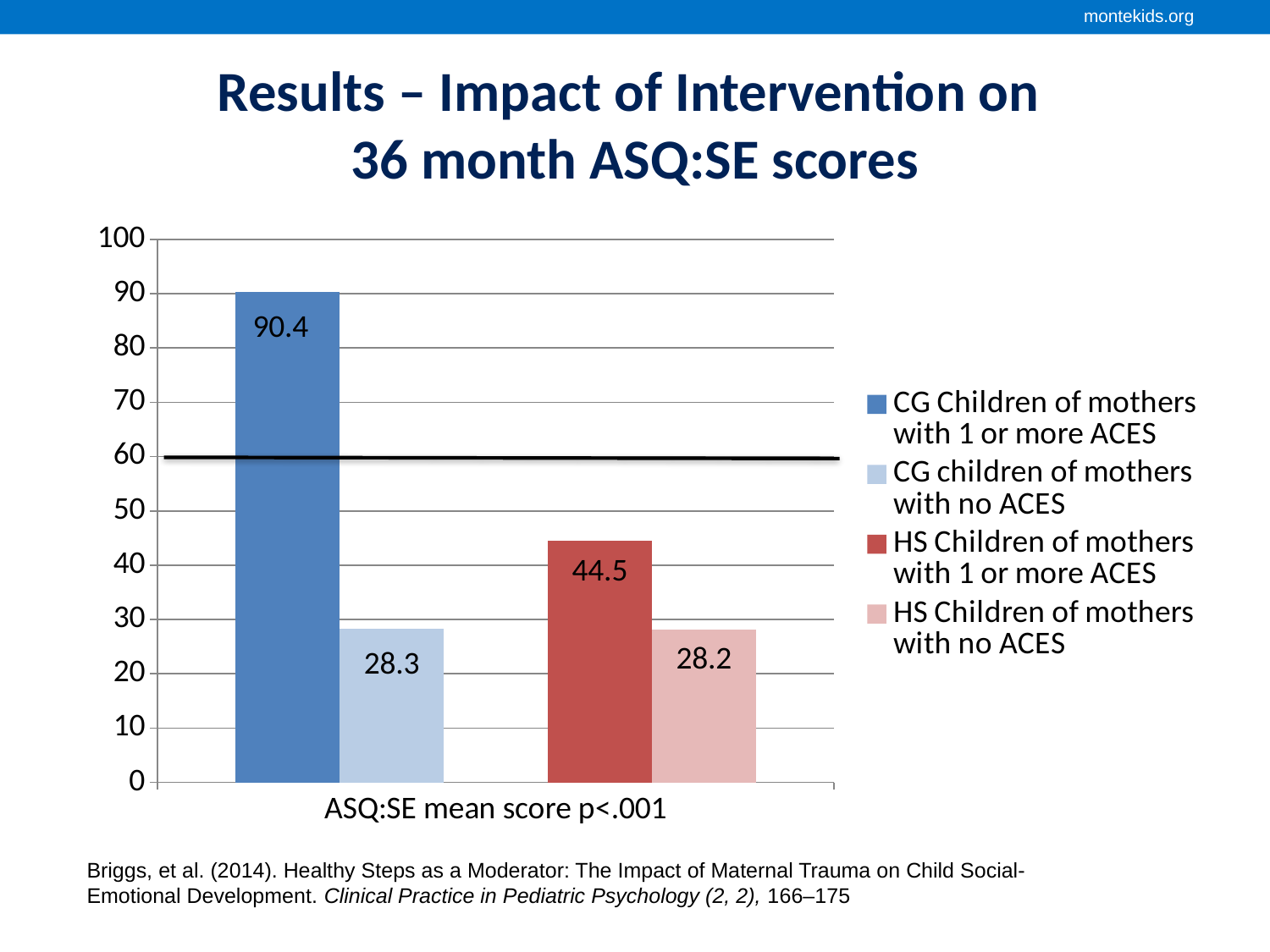
Which series has the highest value? CG Children of mothers with 1 or more ACES Is the value for HS Children of mothers with 1 or more ACES greater or less than 60? less How many series does the legend list? 4 What is the value for CG Children of mothers with 1 or more ACES? 90.4 Which is larger, the value for CG Children of mothers with 1 or more ACES or the value for HS Children of mothers with 1 or more ACES? CG Children of mothers with 1 or more ACES At what value on the y axis is the horizontal black line drawn across the chart? 60 What kind of chart is shown on the slide? bar chart What is the value for HS Children of mothers with 1 or more ACES? 44.5 What is the value for CG children of mothers with no ACES? 28.3 What is the value for HS Children of mothers with no ACES? 28.2 What is the difference between the values for CG Children of mothers with 1 or more ACES and HS Children of mothers with 1 or more ACES? 45.9 What is the x-axis category label under the bars? ASQ:SE mean score p<.001